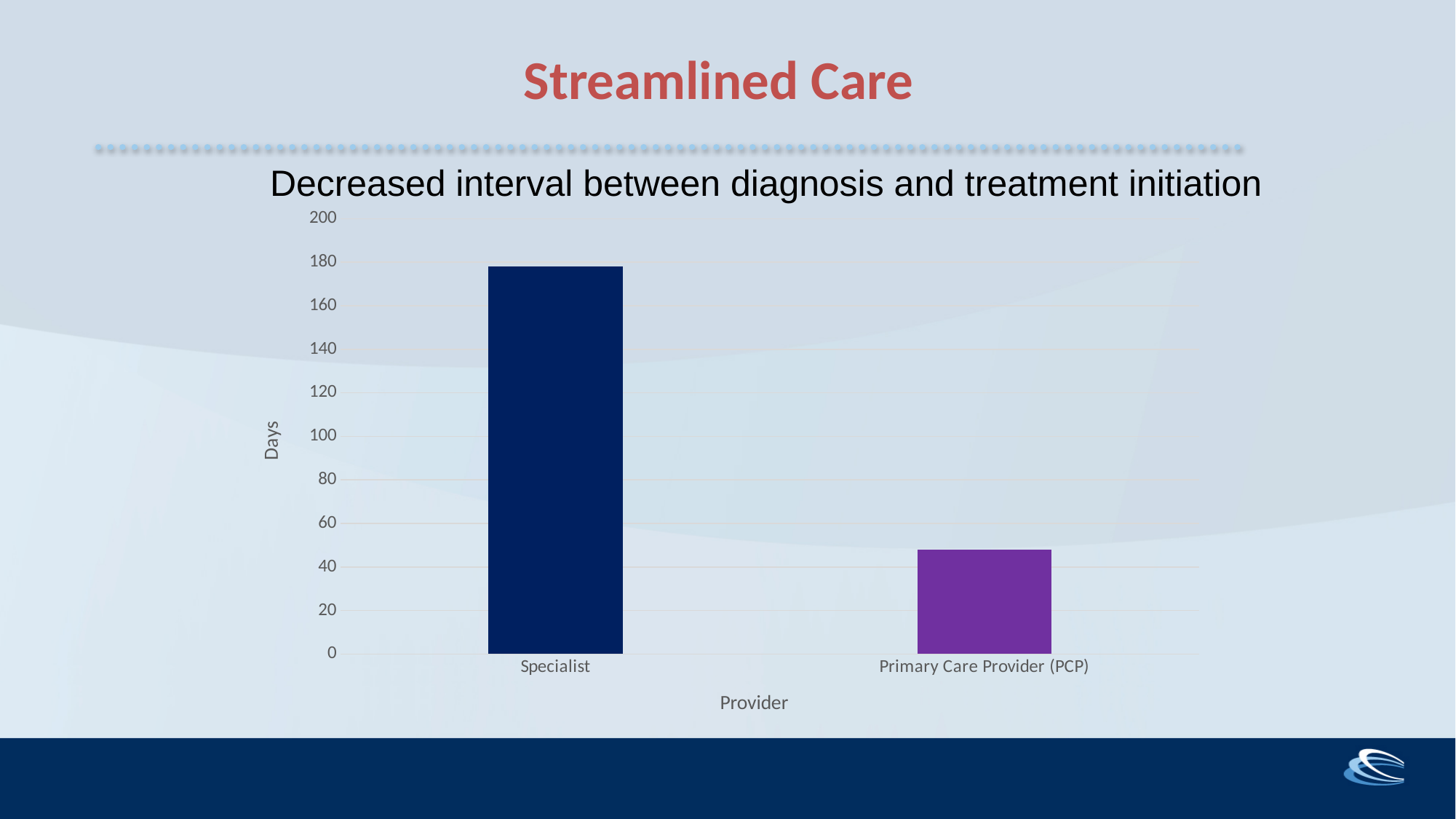
Is the value for Specialist greater or less than 160? greater Which is larger, the value for Specialist or the value for Primary Care Provider (PCP)? Specialist What kind of chart is shown on the slide? bar chart Which provider has the lowest value in the chart? Primary Care Provider (PCP) Which provider has the highest value in the chart? Specialist Is the value for Primary Care Provider (PCP) greater or less than 60? less What is the title of the chart? Decreased interval between diagnosis and treatment initiation How many categories are plotted on the x axis of the chart? 2 What is the label of the vertical axis of the chart? Days Is the value for Primary Care Provider (PCP) greater or less than 40? greater